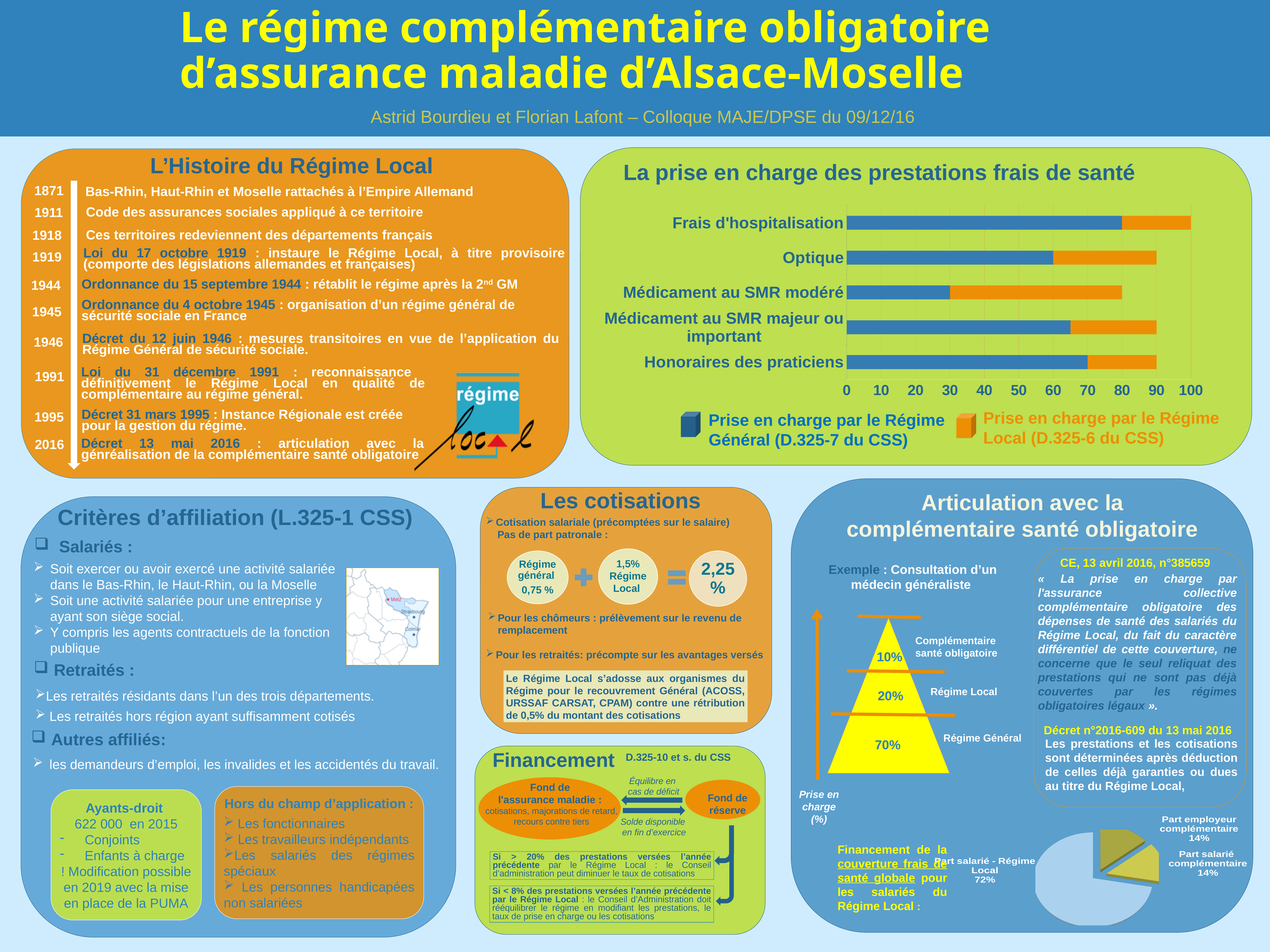
On the pie chart at the bottom right of the slide, what is the value for 'Part salarié - Régime Local'? 72% On the chart titled 'La prise en charge des prestations frais de santé', which has the larger 'Prise en charge par le Régime Général' value: Optique or Honoraires des praticiens? Honoraires des praticiens On the pie chart at the bottom right of the slide, which slice is the largest? Part salarié - Régime Local On the chart titled 'La prise en charge des prestations frais de santé', is the 'Prise en charge par le Régime Général' value for Frais d'hospitalisation greater or less than 70? greater On the chart titled 'La prise en charge des prestations frais de santé', how many series does the legend list? 2 On the chart titled 'La prise en charge des prestations frais de santé', is the 'Prise en charge par le Régime Général' value for Médicament au SMR modéré greater or less than 40? less On the chart titled 'La prise en charge des prestations frais de santé', what kind of chart is shown? bar chart On the chart titled 'La prise en charge des prestations frais de santé', which category has the lowest value for 'Prise en charge par le Régime Général'? Médicament au SMR modéré On the chart titled 'La prise en charge des prestations frais de santé', which category has the highest value for 'Prise en charge par le Régime Général'? Frais d'hospitalisation On the chart titled 'La prise en charge des prestations frais de santé', which series is shown in orange? Prise en charge par le Régime Local (D.325-6 du CSS) On the pie chart at the bottom right of the slide, what is the value for 'Part employeur complémentaire'? 14% On the chart titled 'La prise en charge des prestations frais de santé', how many categories are plotted? 5